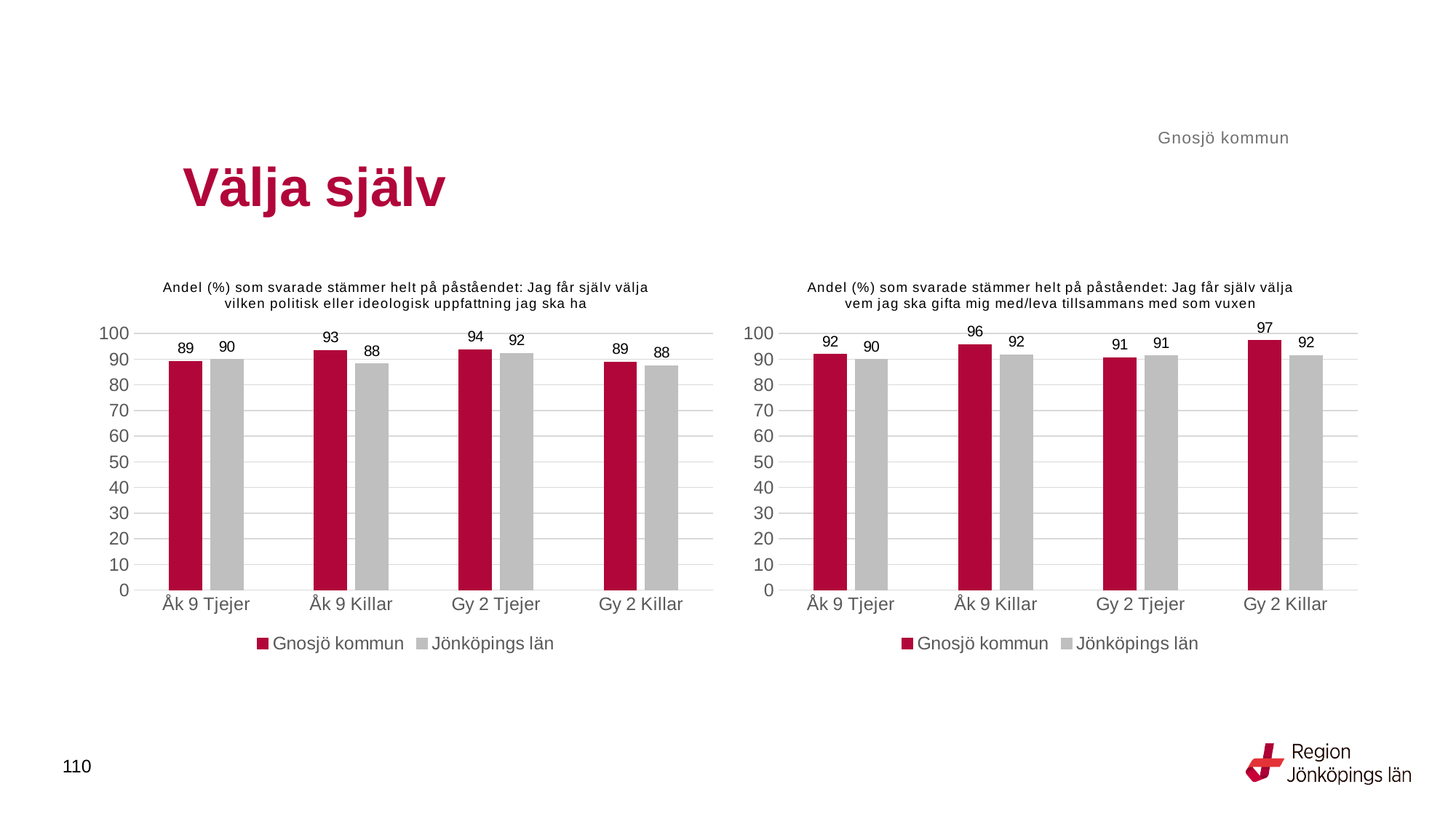
In the right chart (whom to marry/live with), what is the value for Gnosjö kommun for Gy 2 Killar? 97 In the right chart (whom to marry/live with), which is larger for Åk 9 Killar: Gnosjö kommun or Jönköpings län? Gnosjö kommun In the left chart (political or ideological opinion), what is the value for Jönköpings län for Gy 2 Tjejer? 92 In the left chart (political or ideological opinion), what is the difference between Gnosjö kommun and Jönköpings län for Åk 9 Killar? 5 What kind of chart is the left chart? Bar chart In the left chart (political or ideological opinion), what is the value for Gnosjö kommun for Åk 9 Killar? 93 How many categories are shown on the x axis of the left chart? 4 In the left chart (political or ideological opinion), which category has the highest Gnosjö kommun value? Gy 2 Tjejer How many series does the legend of the right chart list? 2 In the right chart (whom to marry/live with), what is the value for Jönköpings län for Åk 9 Tjejer? 90 In the right chart (whom to marry/live with), which category has the lowest Gnosjö kommun value? Gy 2 Tjejer In the right chart (whom to marry/live with), what is the difference between Gnosjö kommun and Jönköpings län for Gy 2 Killar? 5